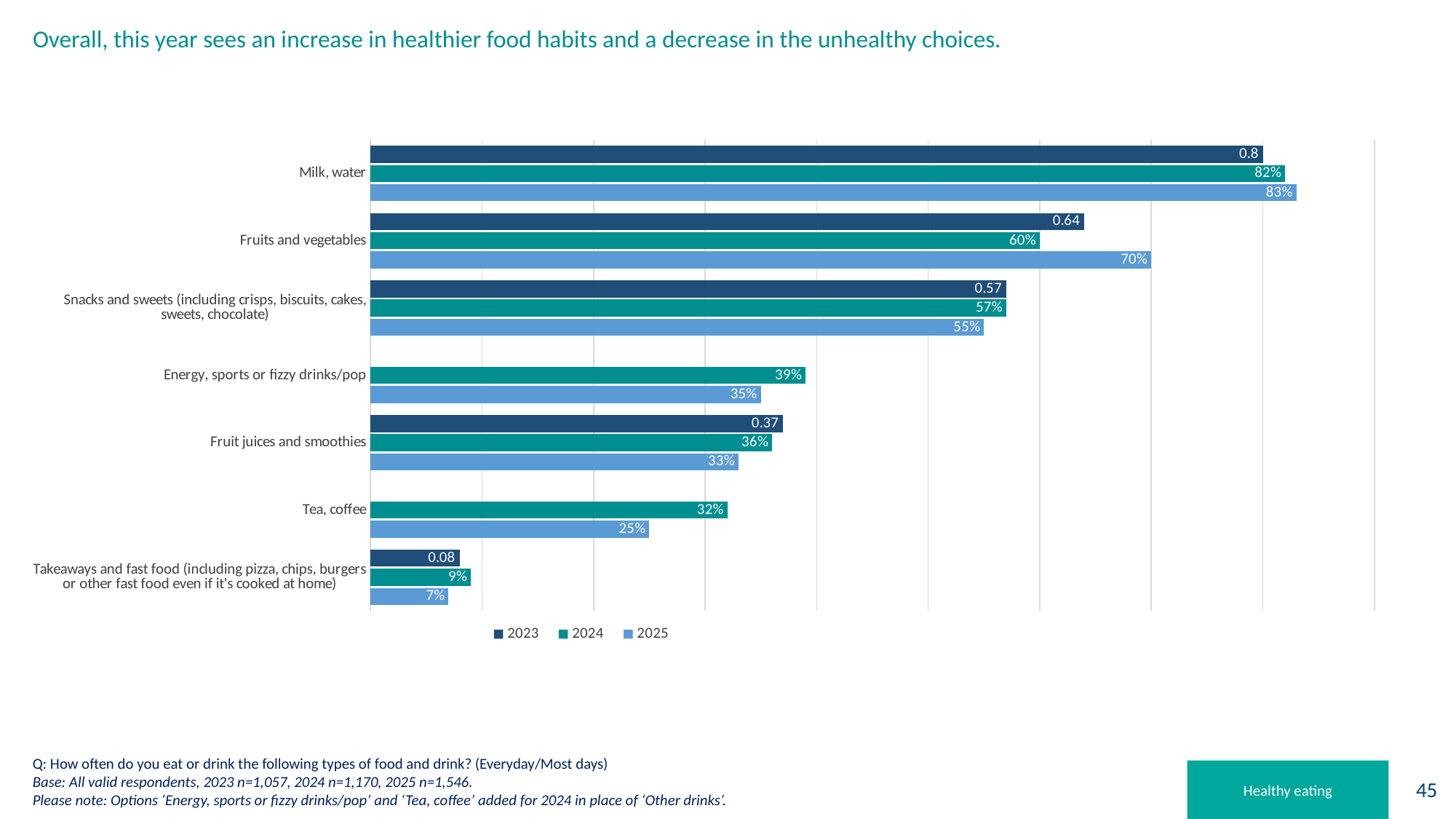
What is the value for Milk, water in 2025? 83% What is the difference between the 2024 and 2025 values for Tea, coffee? 7% What is the value for Tea, coffee in 2025? 25% What is the value for Fruits and vegetables in 2024? 60% How many categories are shown on the chart? 7 Which category has the lowest value in 2024? Takeaways and fast food (including pizza, chips, burgers or other fast food even if it's cooked at home) What is the data label shown for Fruit juices and smoothies in 2023? 0.37 Which category has the highest value in 2025? Milk, water What is the difference between the 2025 and 2024 values for Fruits and vegetables? 10% What kind of chart is shown on the slide? Bar chart Which is larger for Energy, sports or fizzy drinks/pop: the 2024 value or the 2025 value? 2024 How many series does the legend list? 3